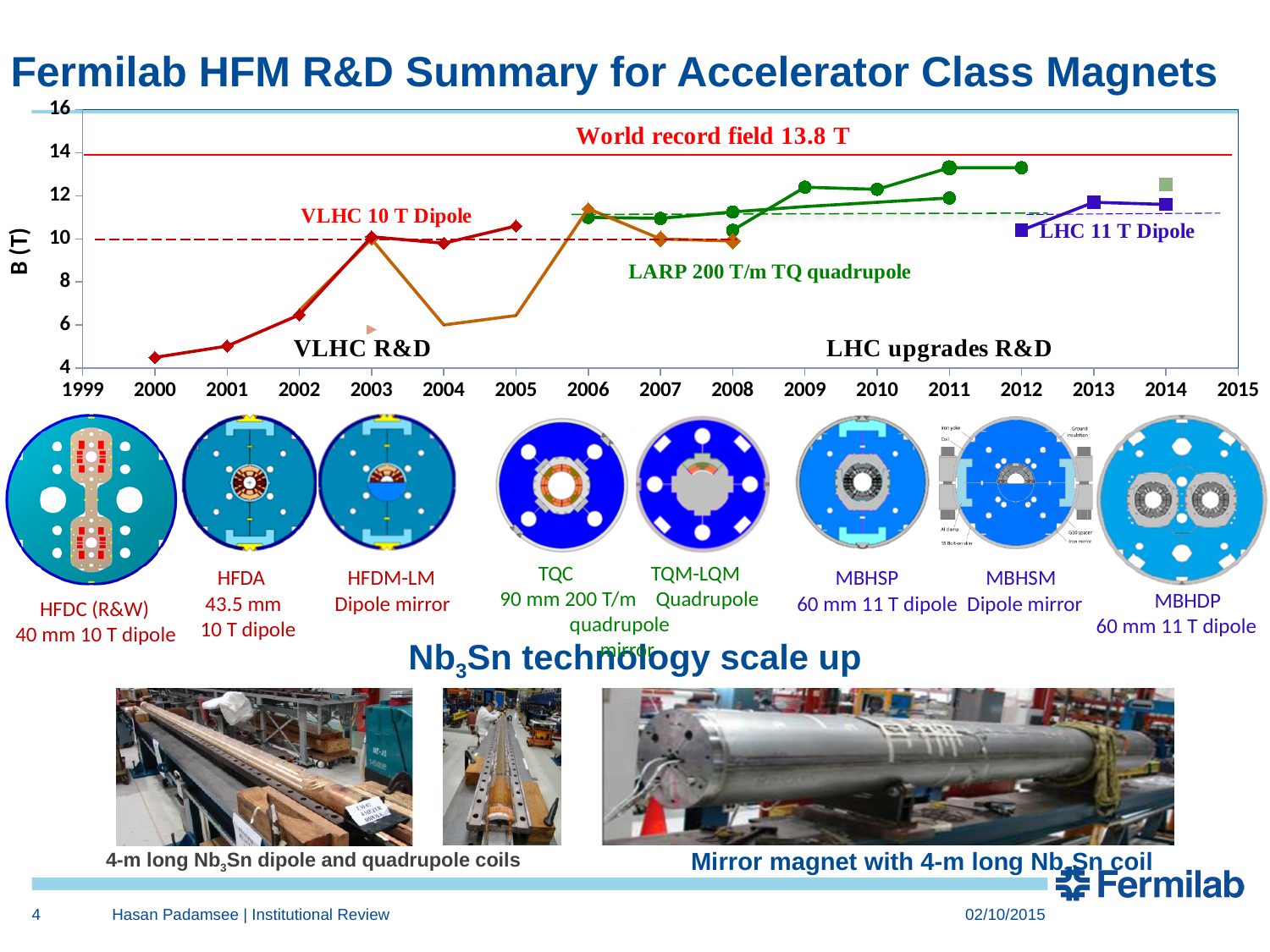
What field value is given in the annotation for the VLHC dipole on the chart? 10 T Which series reaches a higher value in 2012, the green series or the blue series? green series Is the value of the blue series in 2013 greater or less than 10? greater What field value is given in the annotation for the LHC dipole on the chart? 11 T Does the red series rise or fall between 2000 and 2003? rise What kind of chart is shown at the top of the slide? line chart What is the label on the vertical axis of the chart? B (T) How many year labels are shown on the horizontal axis of the chart? 17 Is the value of the orange series in 2004 greater or less than 8? less What world record field value is annotated on the chart? 13.8 T Is the value of the red series in 2000 greater or less than 6? less